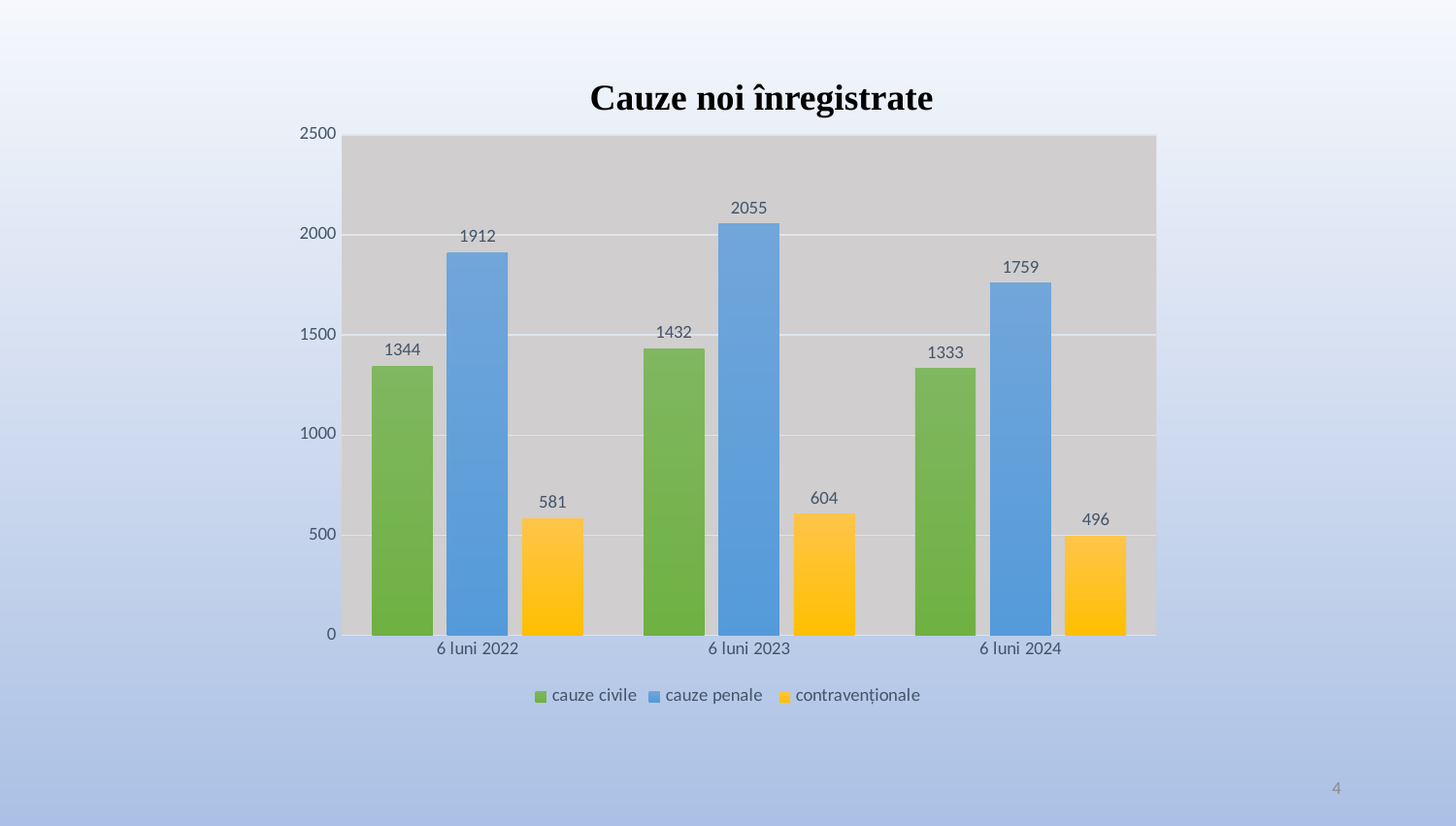
In which period is the value for cauze penale highest? 6 luni 2023 Is the value for cauze penale in 6 luni 2022 greater or less than 1500? greater What is the value for cauze penale in 6 luni 2023? 2055 What is the difference between cauze penale in 6 luni 2023 and 6 luni 2024? 296 What is the value for cauze civile in 6 luni 2022? 1344 How many series does the legend list? 3 What kind of chart is shown? bar chart How many periods are shown on the x axis? 3 What is the title of the chart? Cauze noi înregistrate What is the value for contravenționale in 6 luni 2024? 496 In which period is the value for contravenționale lowest? 6 luni 2024 Which is larger: cauze civile in 6 luni 2022 or cauze civile in 6 luni 2024? 6 luni 2022